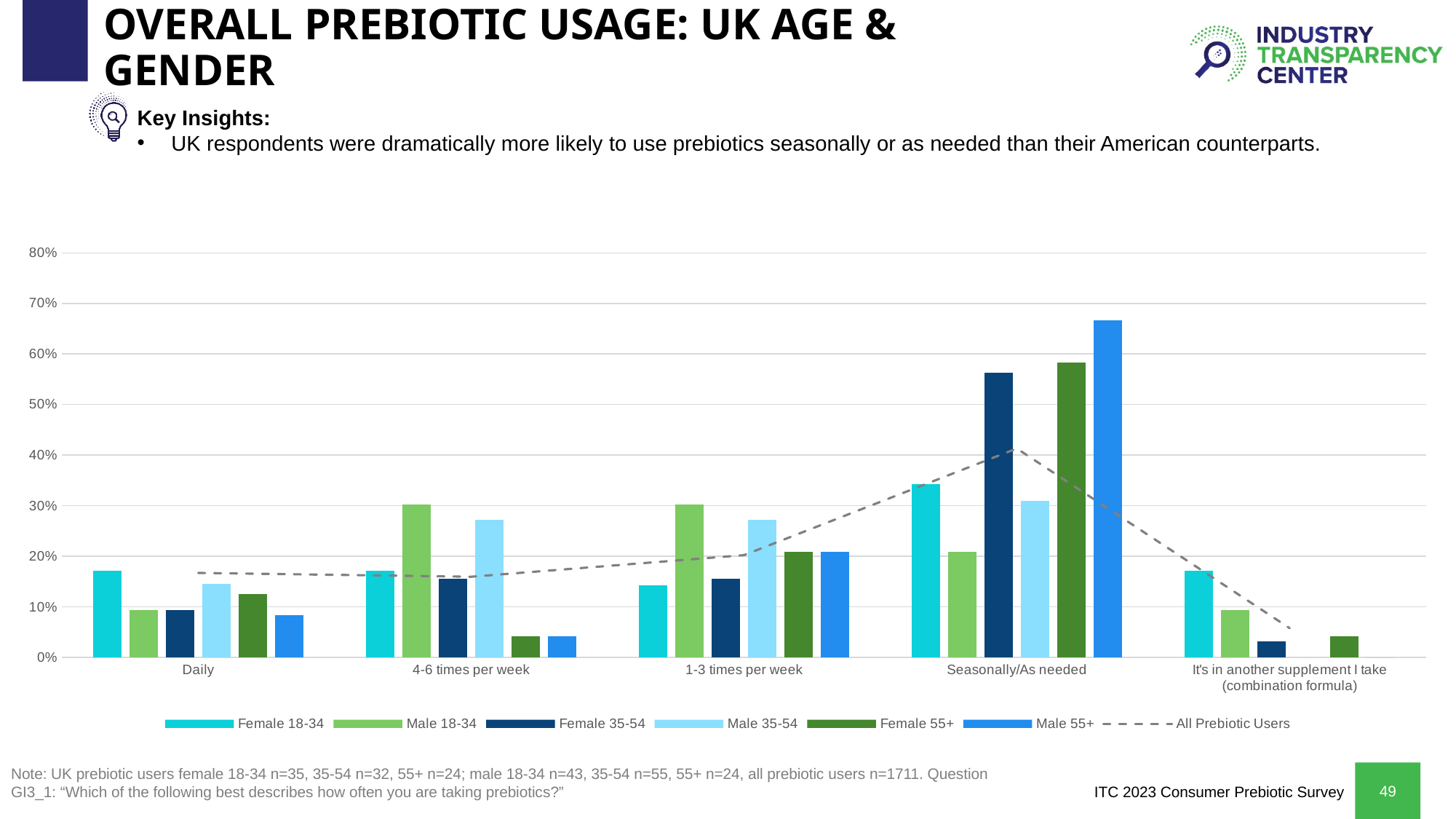
Is the value for Female 35-54 in the Seasonally/As needed category greater or less than 50%? greater In the 4-6 times per week category, which is larger: Male 35-54 or Female 35-54? Male 35-54 What kind of chart is shown on the slide? combination bar and line chart Is the value for Male 55+ in the Seasonally/As needed category greater or less than 60%? greater How many series does the legend list? 7 At which category does the dashed All Prebiotic Users line reach its peak? Seasonally/As needed Which series has the highest value in the Seasonally/As needed category? Male 55+ In the Daily category, which is larger: Female 18-34 or Male 18-34? Female 18-34 Is the value for Male 55+ in the 4-6 times per week category greater or less than 10%? less How many usage-frequency categories are shown on the x axis? 5 Which category has the tallest bar in the chart? Seasonally/As needed Which series has the lowest value in the Daily category? Male 55+